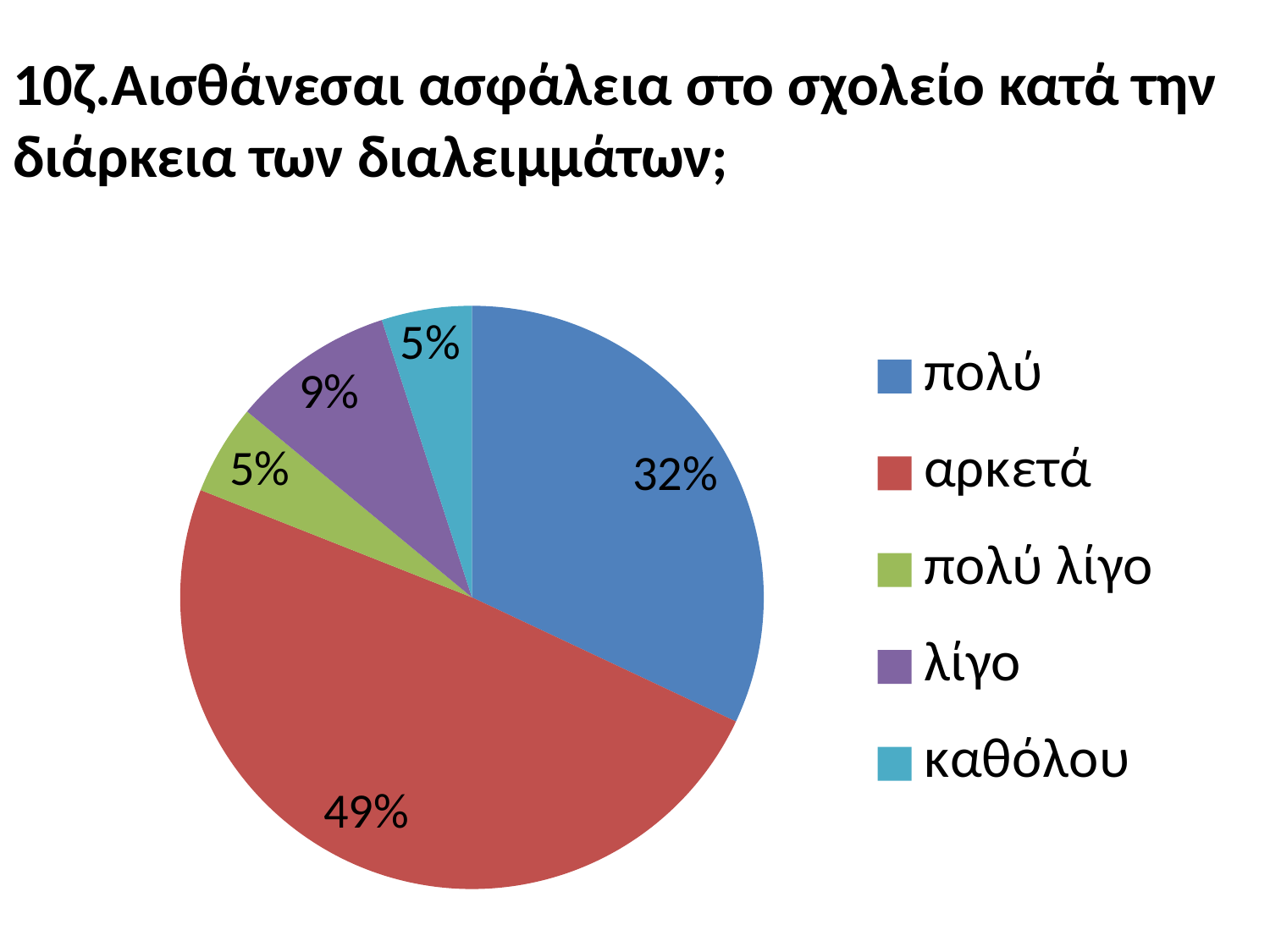
What percentage of the pie is the 'αρκετά' slice? 49% What percentage of the pie is the 'πολύ' slice? 32% What is the difference in percentage points between the 'λίγο' and 'καθόλου' slices? 4 Which category has the largest slice of the pie? αρκετά What is the difference in percentage points between the 'αρκετά' and 'πολύ' slices? 17 What percentage of the pie is the 'καθόλου' slice? 5% How many categories does the legend list? 5 Which slice is larger, 'πολύ' or 'λίγο'? πολύ Which colour represents 'πολύ λίγο' in the legend? green What kind of chart is shown on the slide? pie chart What is the title of the chart on the slide? 10ζ.Αισθάνεσαι ασφάλεια στο σχολείο κατά την διάρκεια των διαλειμμάτων;